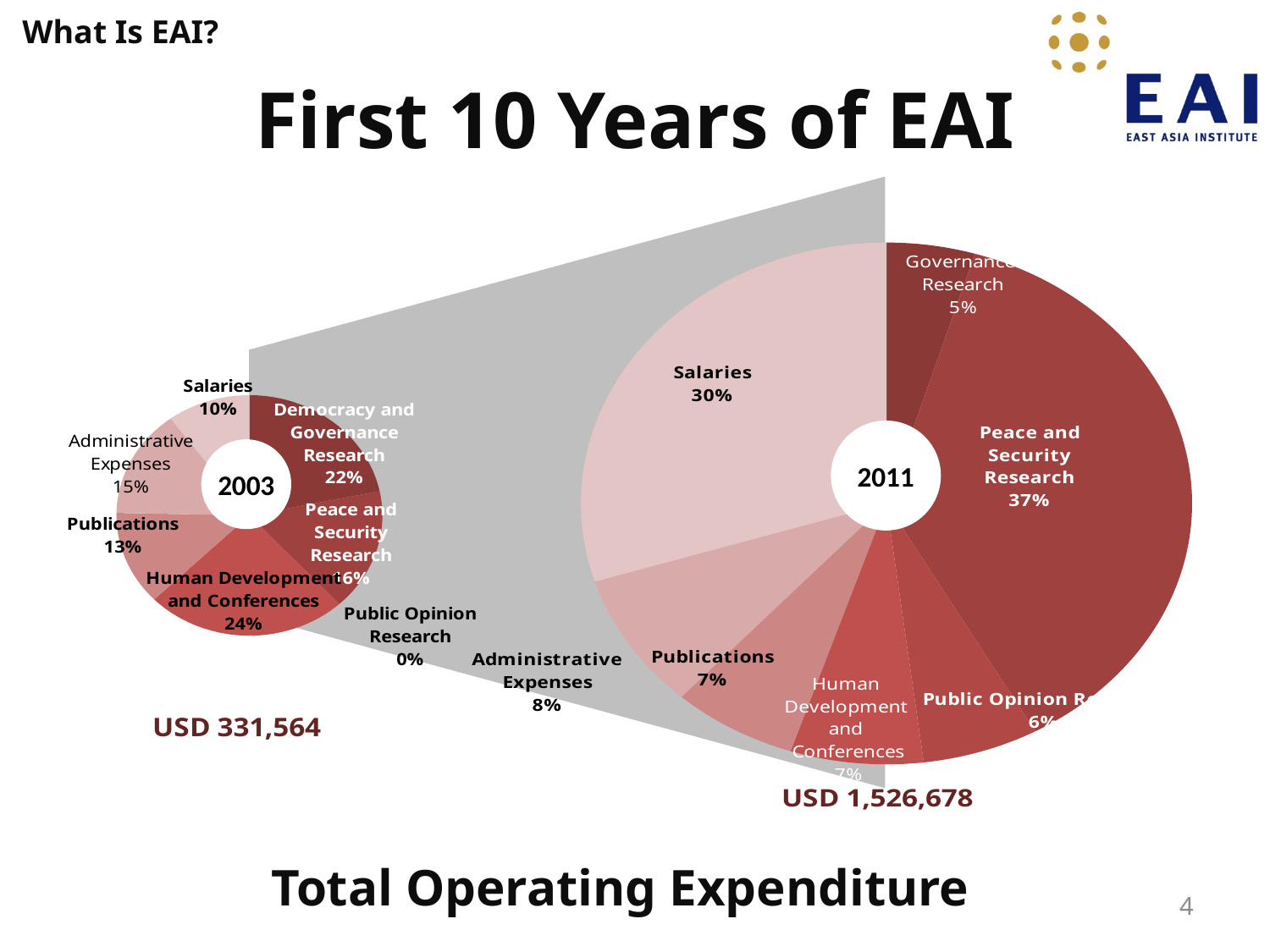
What total operating expenditure is shown below the 2011 chart? USD 1,526,678 What kind of chart is used to show the 2003 and 2011 expenditure breakdowns? Pie chart In the 2003 chart, which category has the largest share? Human Development and Conferences How many categories are shown in the 2003 chart? 7 Which year shows a larger share for Salaries, 2003 or 2011? 2011 In the 2011 chart, how many percentage points larger is Peace and Security Research than Salaries? 7 percentage points In the 2011 chart, what percentage is shown for Salaries? 30% In the 2003 chart, which category has the smallest share? Public Opinion Research In the 2003 chart, what percentage is shown for Democracy and Governance Research? 22% In the 2011 chart, what share of expenditure went to Peace and Security Research? 37% In the 2011 chart, which category has the largest share? Peace and Security Research In the 2003 chart, what share of expenditure went to Human Development and Conferences? 24%